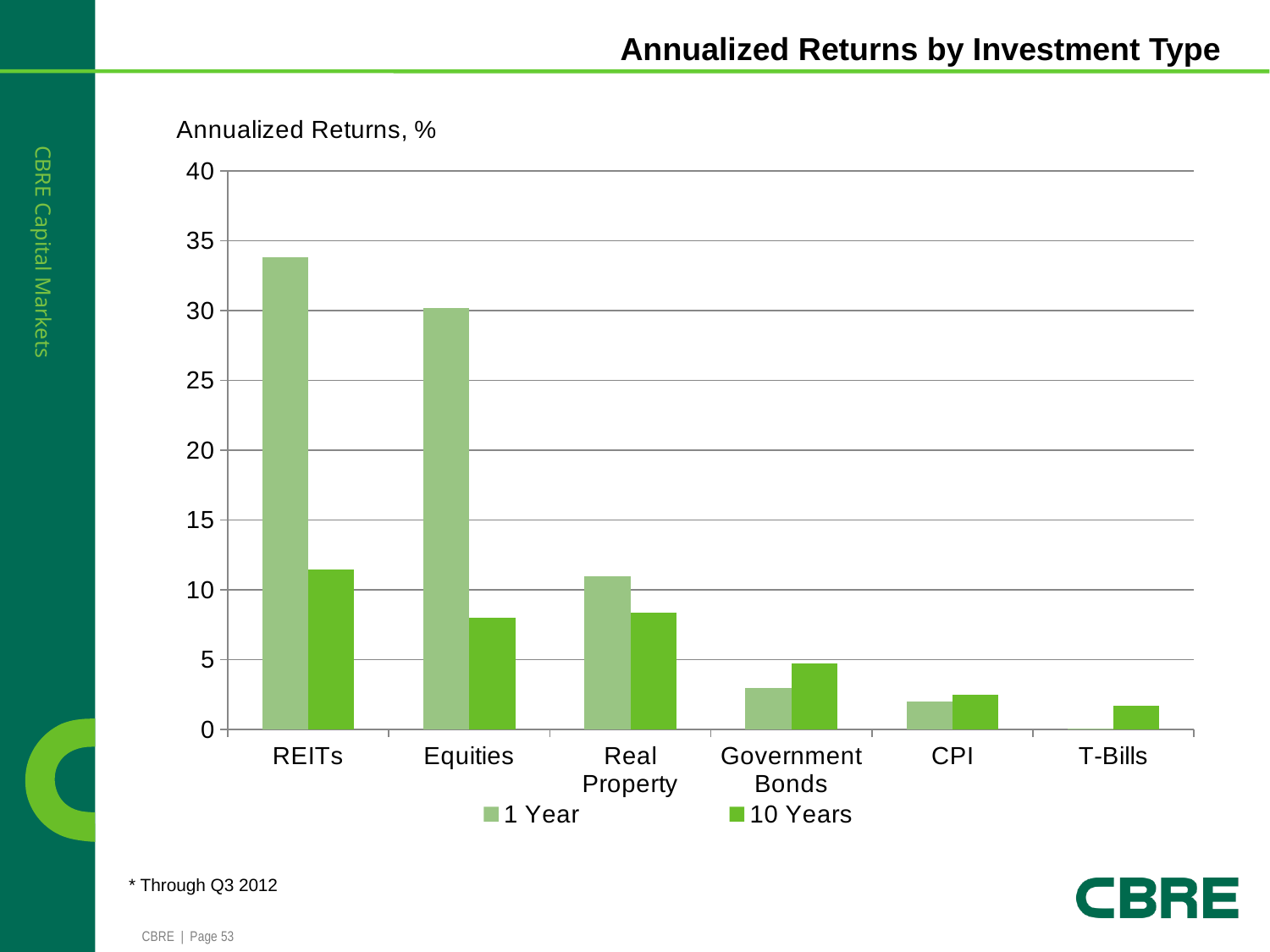
What is the title of the chart? Annualized Returns, % How many series does the legend list? 2 Is the 1 Year value for REITs greater or less than 30? greater Is the 1 Year value for Real Property greater or less than 10? greater What kind of chart is shown on the slide? bar chart Is the 10 Years value for Equities greater or less than 10? less Which investment type has the highest 1 Year annualized return? REITs Which is larger, the 1 Year value for Equities or the 1 Year value for Real Property? Equities Which investment type has the lowest 10 Years annualized return? T-Bills Which is larger for Government Bonds, the 1 Year value or the 10 Years value? 10 Years How many investment types are shown on the x axis? 6